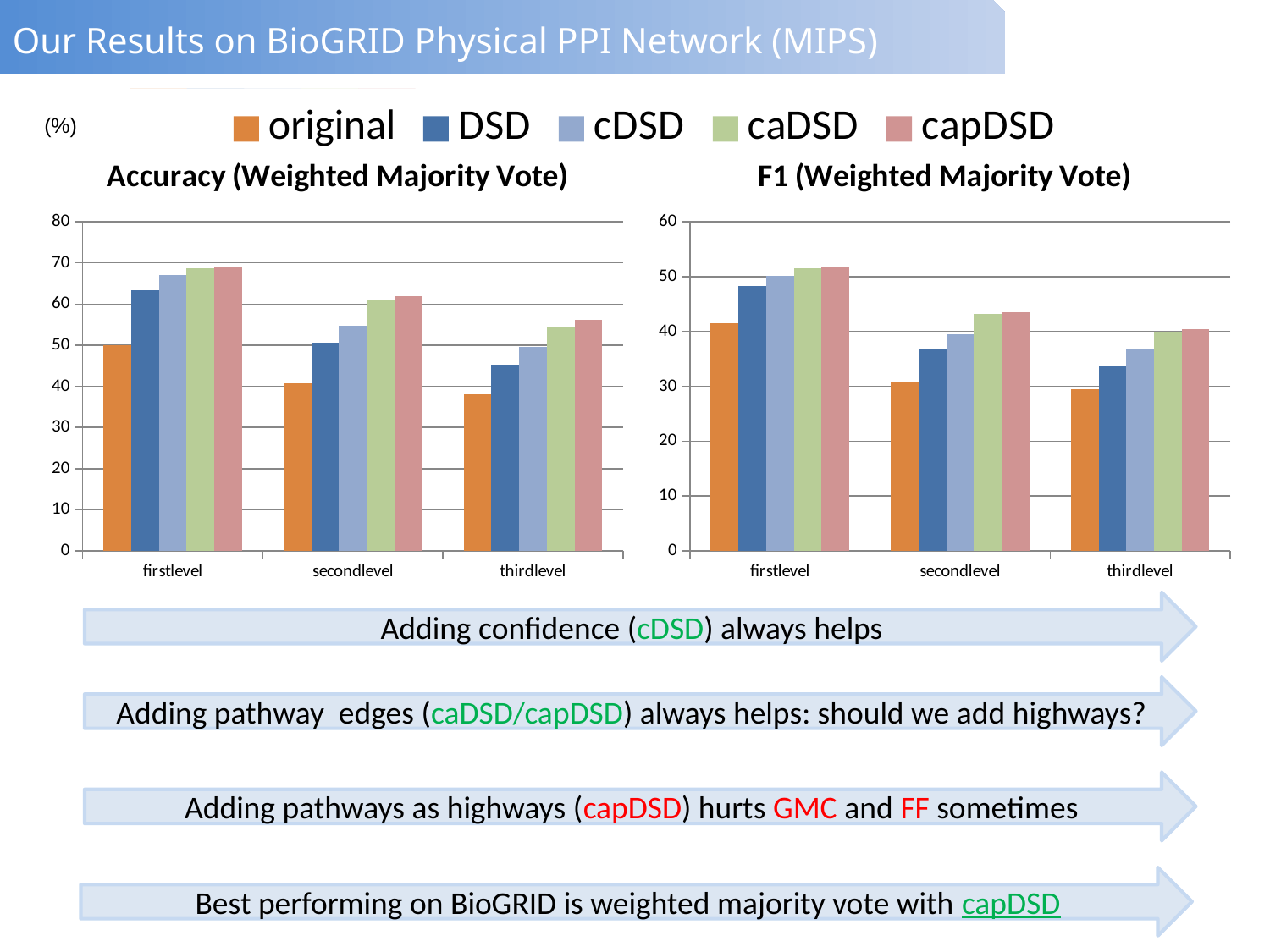
In the F1 (Weighted Majority Vote) chart, is the value for DSD at firstlevel greater or less than 50? less How many series does the legend list for the charts? 5 What kind of chart is the Accuracy (Weighted Majority Vote) chart? bar chart What are the five series listed in the legend? original, DSD, cDSD, caDSD, capDSD In the Accuracy (Weighted Majority Vote) chart, is the value for original at thirdlevel greater or less than 30? greater In the F1 (Weighted Majority Vote) chart, do the original values rise or fall from firstlevel to thirdlevel? fall In the F1 (Weighted Majority Vote) chart, which category has the lowest original bar? thirdlevel In the Accuracy (Weighted Majority Vote) chart, which is larger at firstlevel: DSD or cDSD? cDSD In the Accuracy (Weighted Majority Vote) chart, is the value for original at firstlevel greater or less than 40? greater How many categories are shown on the x axis of the F1 (Weighted Majority Vote) chart? 3 In the Accuracy (Weighted Majority Vote) chart, which category has the highest original bar? firstlevel